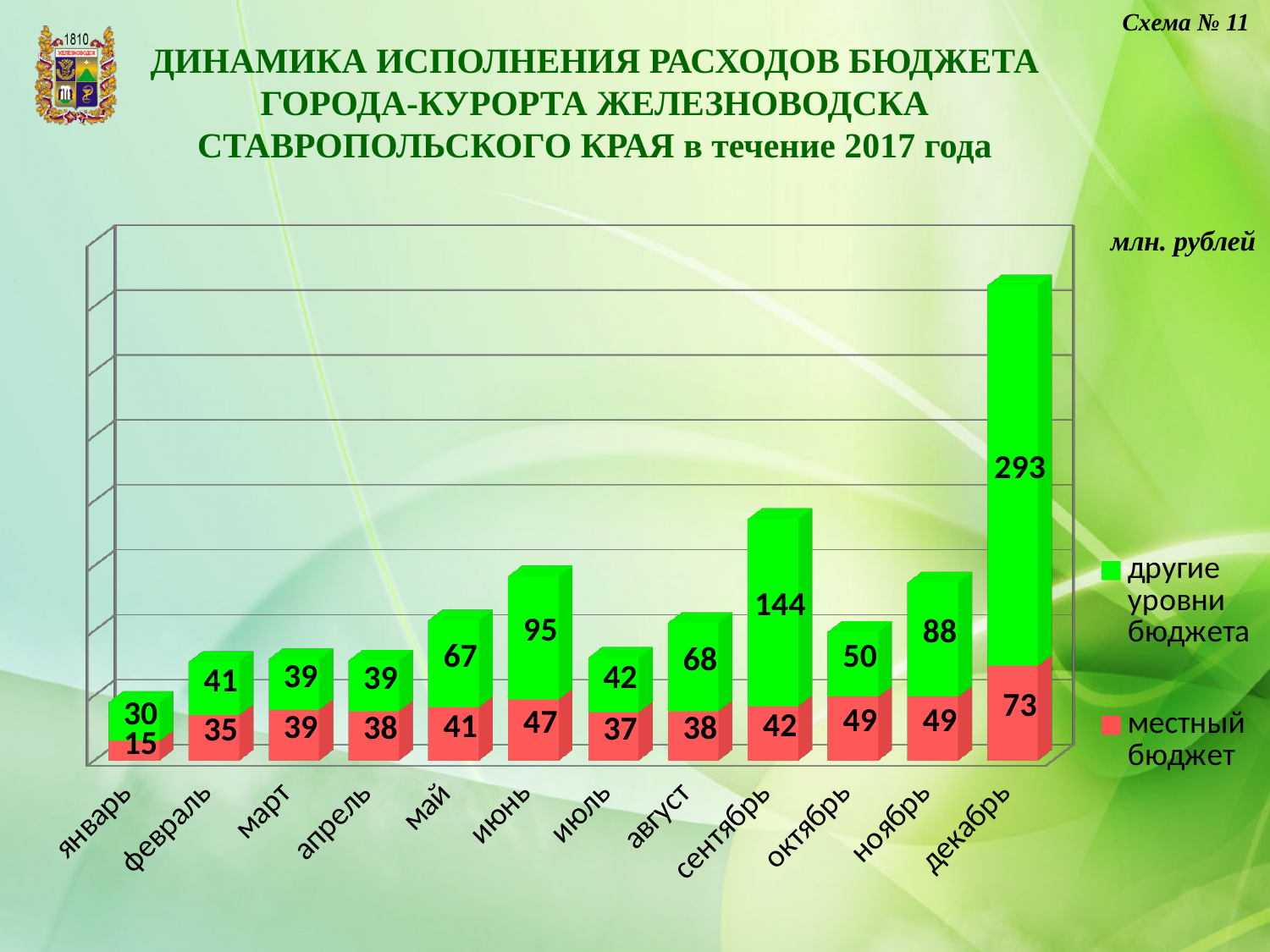
What is the total of the stacked bar for декабрь? 366 What is the value for "местный бюджет" in январь? 15 Which month has the highest value for "другие уровни бюджета"? декабрь What is the value for "местный бюджет" in июнь? 47 How many series does the legend list? 2 What kind of chart is shown on the slide? stacked bar chart Which month has the lowest value for "местный бюджет"? январь What unit is stated for the values on the chart? млн. рублей How many months are shown on the x axis? 12 Which is larger: the "местный бюджет" value for май or for июль? май What is the value for "другие уровни бюджета" in декабрь? 293 What is the difference between the "другие уровни бюджета" values for сентябрь and июнь? 49